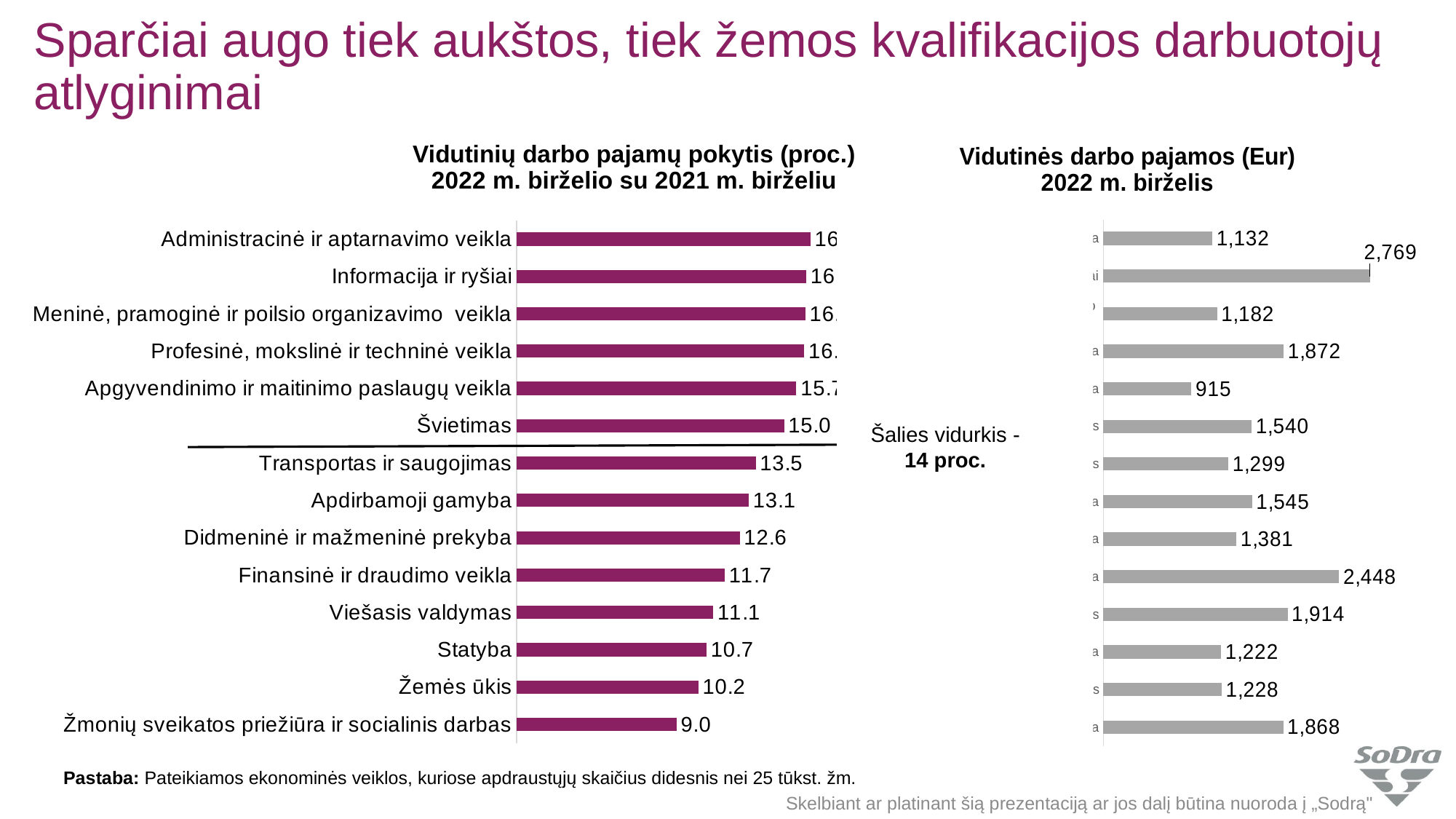
In the left chart 'Vidutinių darbo pajamų pokytis (proc.)', what is the value for Transportas ir saugojimas? 13.5 In the right chart 'Vidutinės darbo pajamos (Eur)', what is the highest value shown? 2,769 In the right chart 'Vidutinės darbo pajamos (Eur)', what is the lowest value shown? 915 In the left chart 'Vidutinių darbo pajamų pokytis (proc.)', which category has the lowest value? Žmonių sveikatos priežiūra ir socialinis darbas In the left chart 'Vidutinių darbo pajamų pokytis (proc.)', do the values rise or fall going from the top bar to the bottom bar? fall In the left chart 'Vidutinių darbo pajamų pokytis (proc.)', what is the value for Statyba? 10.7 In the left chart 'Vidutinių darbo pajamų pokytis (proc.)', what is the value for Švietimas? 15.0 In the left chart 'Vidutinių darbo pajamų pokytis (proc.)', what is the difference between Transportas ir saugojimas and Statyba? 2.8 What kind of chart is the left chart, 'Vidutinių darbo pajamų pokytis (proc.)'? bar chart How many categories are shown in the left chart 'Vidutinių darbo pajamų pokytis (proc.)'? 14 What national average (Šalies vidurkis) is stated between the two charts? 14 proc. In the left chart 'Vidutinių darbo pajamų pokytis (proc.)', which is larger: Finansinė ir draudimo veikla or Viešasis valdymas? Finansinė ir draudimo veikla